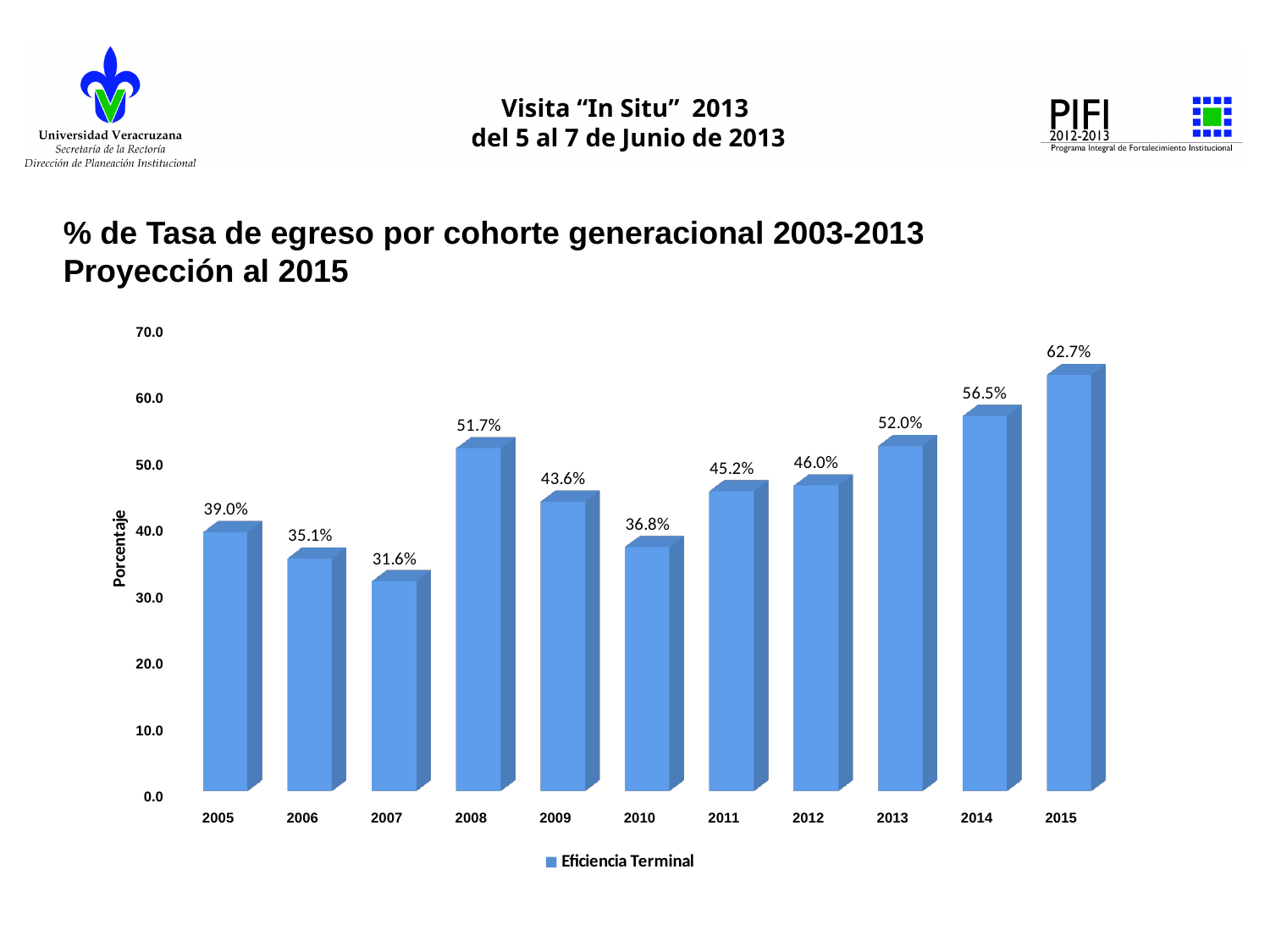
What is the value for 2012? 46.0% Is the value for 2013 greater or less than 50.0? greater Which year has the lowest value? 2007 What is the value for 2005? 39.0% How many years are shown on the x axis? 11 Which is larger, the value for 2010 or the value for 2006? 2010 What series name does the legend show? Eficiencia Terminal What is the difference between the values for 2008 and 2009? 8.1% Which year has the highest value? 2015 What is the value for 2008? 51.7% What kind of chart is this? bar chart What is the difference between the values for 2015 and 2014? 6.2%